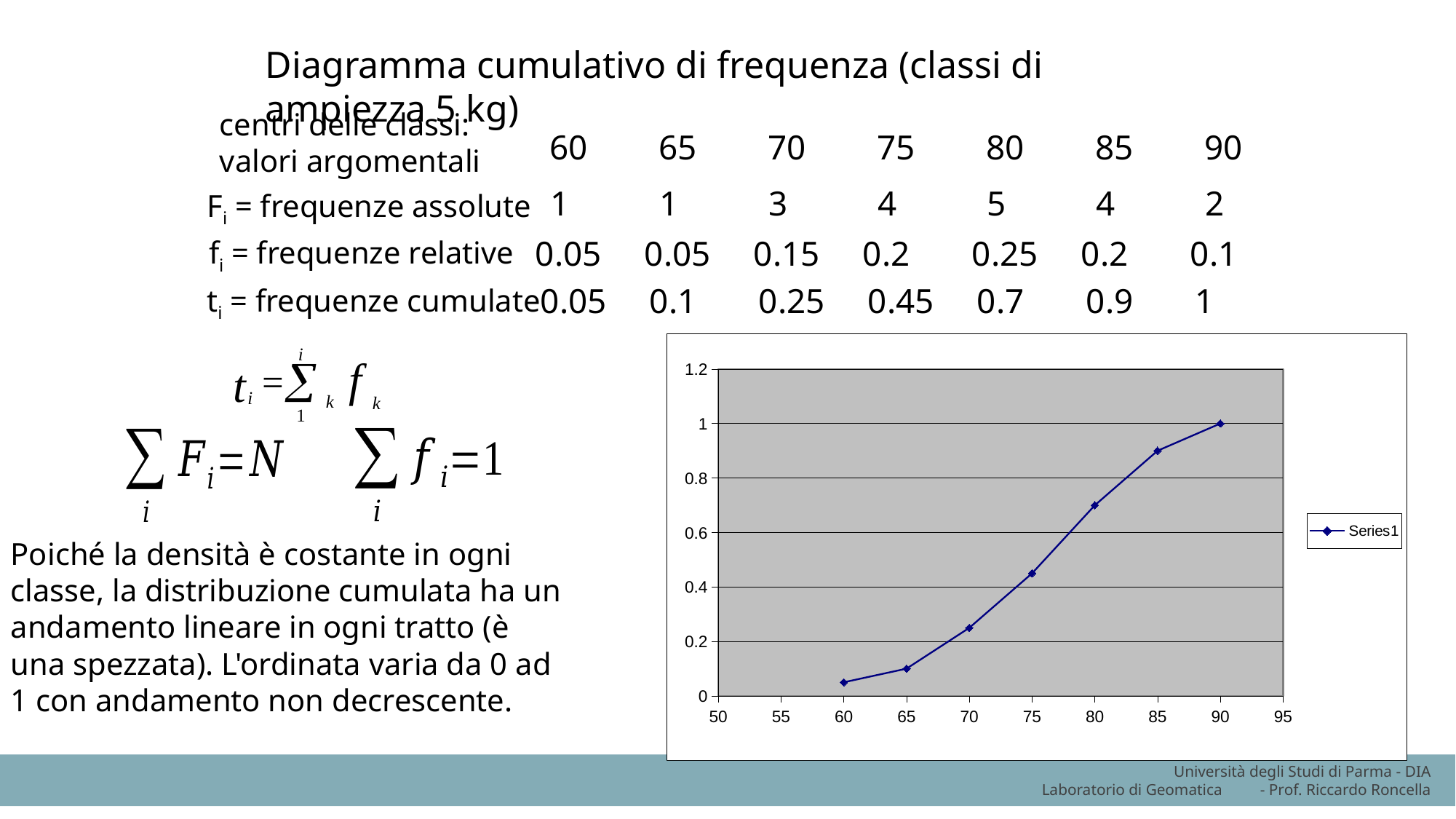
Is the plotted value at x = 80 greater or less than 0.6? greater How many data points are plotted on the chart? 7 What kind of chart is shown on the slide? line chart How many series does the chart legend list? 1 What is the cumulative frequency value plotted at x = 90? 1 Is the plotted value at x = 70 greater or less than 0.4? less What is the cumulative frequency value plotted at x = 60? 0.05 At which x value is the plotted value highest? 90 Do the plotted values rise or fall as x increases from 60 to 90? rise What is the cumulative frequency value plotted at x = 75? 0.45 What is the name of the series shown in the chart legend? Series1 At which x value is the plotted value lowest? 60